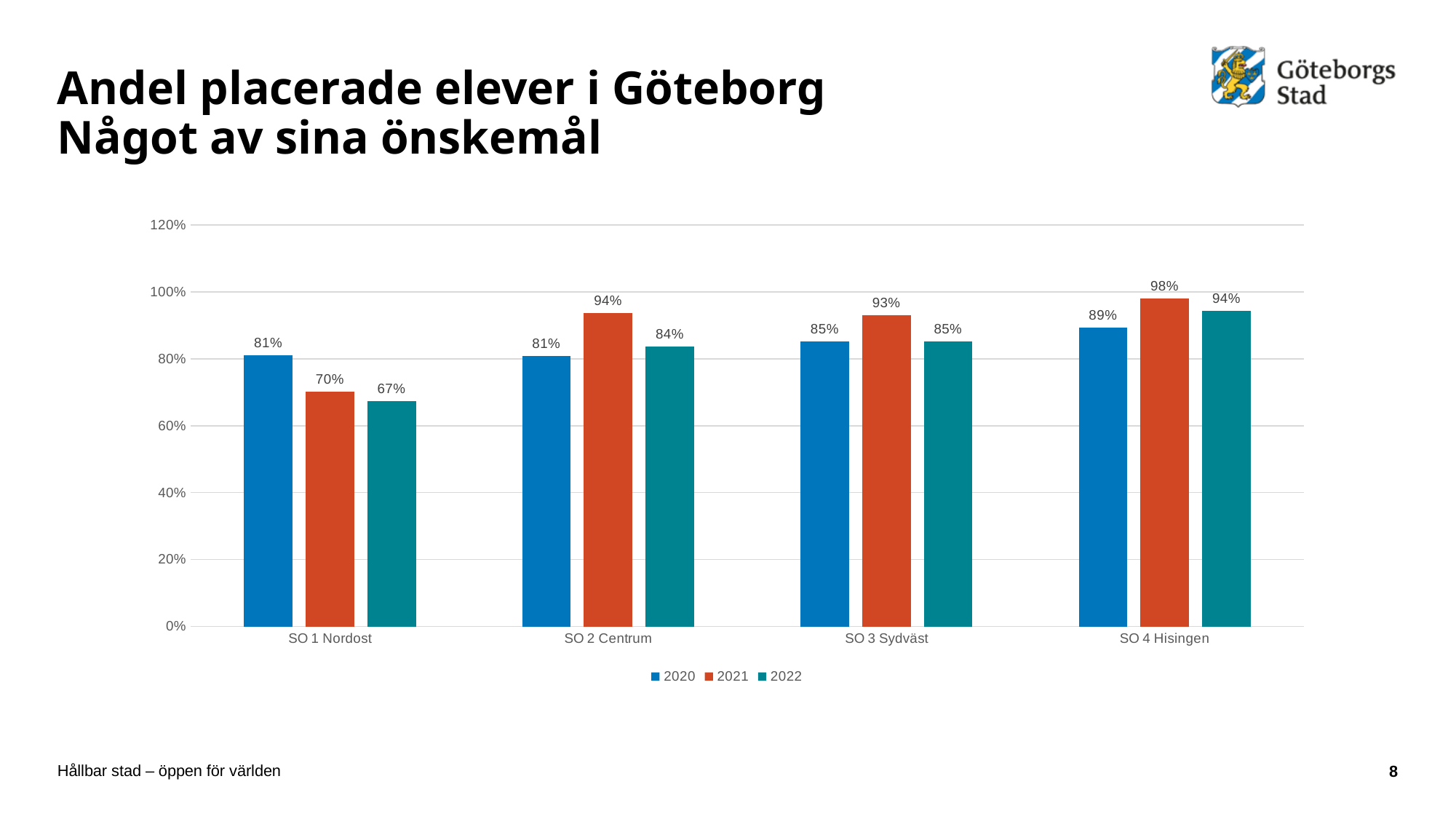
What is the value for SO 4 Hisingen in 2020? 89% What is the value for SO 2 Centrum in 2022? 84% Which category has the highest value in the 2021 series? SO 4 Hisingen Which category has the lowest value in the 2022 series? SO 1 Nordost Is the value for SO 1 Nordost in 2022 greater or less than 80%? less What is the value for SO 1 Nordost in 2021? 70% How many categories are shown on the x axis? 4 Which is larger for SO 3 Sydväst: the 2020 value or the 2021 value? 2021 What is the difference between the 2020 and 2021 values for SO 2 Centrum? 13% What is the difference between the 2021 and 2022 values for SO 1 Nordost? 3% What kind of chart is shown on the slide? bar chart How many series does the legend list? 3